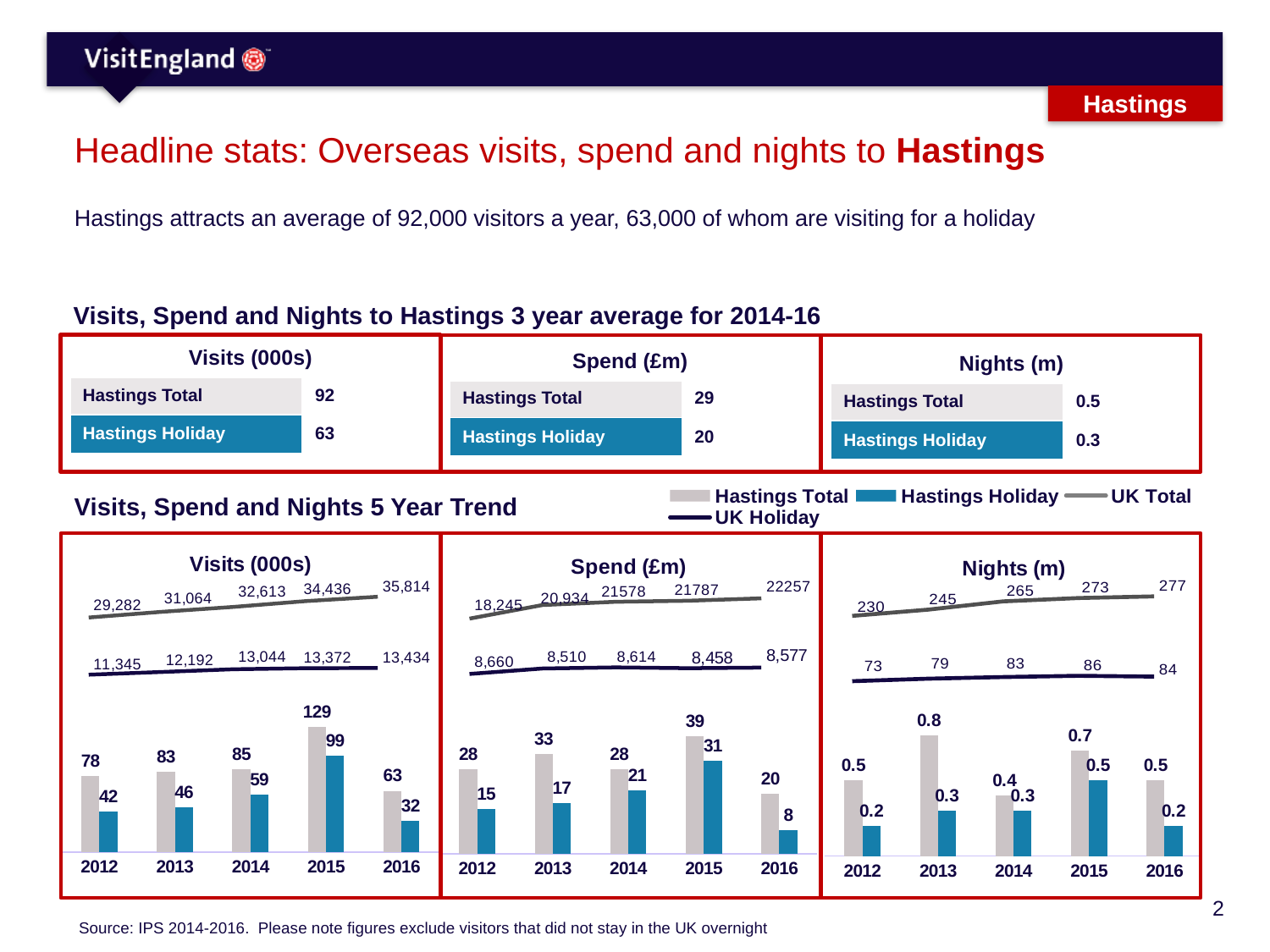
In the Visits (000s) 5 year trend chart, what is the difference between Hastings Total and Hastings Holiday in 2012? 36 How many series does the legend for the 5 Year Trend charts list? 4 In the Spend (£m) 5 year trend chart, which year has the highest Hastings Total value? 2015 In the Nights (m) 5 year trend chart, does the UK Total line rise or fall from 2012 to 2016? rise In the Visits (000s) 5 year trend chart, what is the Hastings Total value for 2015? 129 In the Visits (000s) 5 year trend chart, what is the UK Total value for 2016? 35,814 In the Spend (£m) 5 year trend chart, is the Hastings Total value larger in 2013 or in 2014? 2013 In the Nights (m) 5 year trend chart, what is the Hastings Total value for 2013? 0.8 How many years are shown on the x axis of the Nights (m) 5 year trend chart? 5 In the Spend (£m) 5 year trend chart, what is the Hastings Holiday value for 2016? 8 In the Spend (£m) 5 year trend chart, what is the UK Holiday value for 2014? 8,614 In the Visits (000s) 5 year trend chart, which year has the lowest Hastings Holiday value? 2016